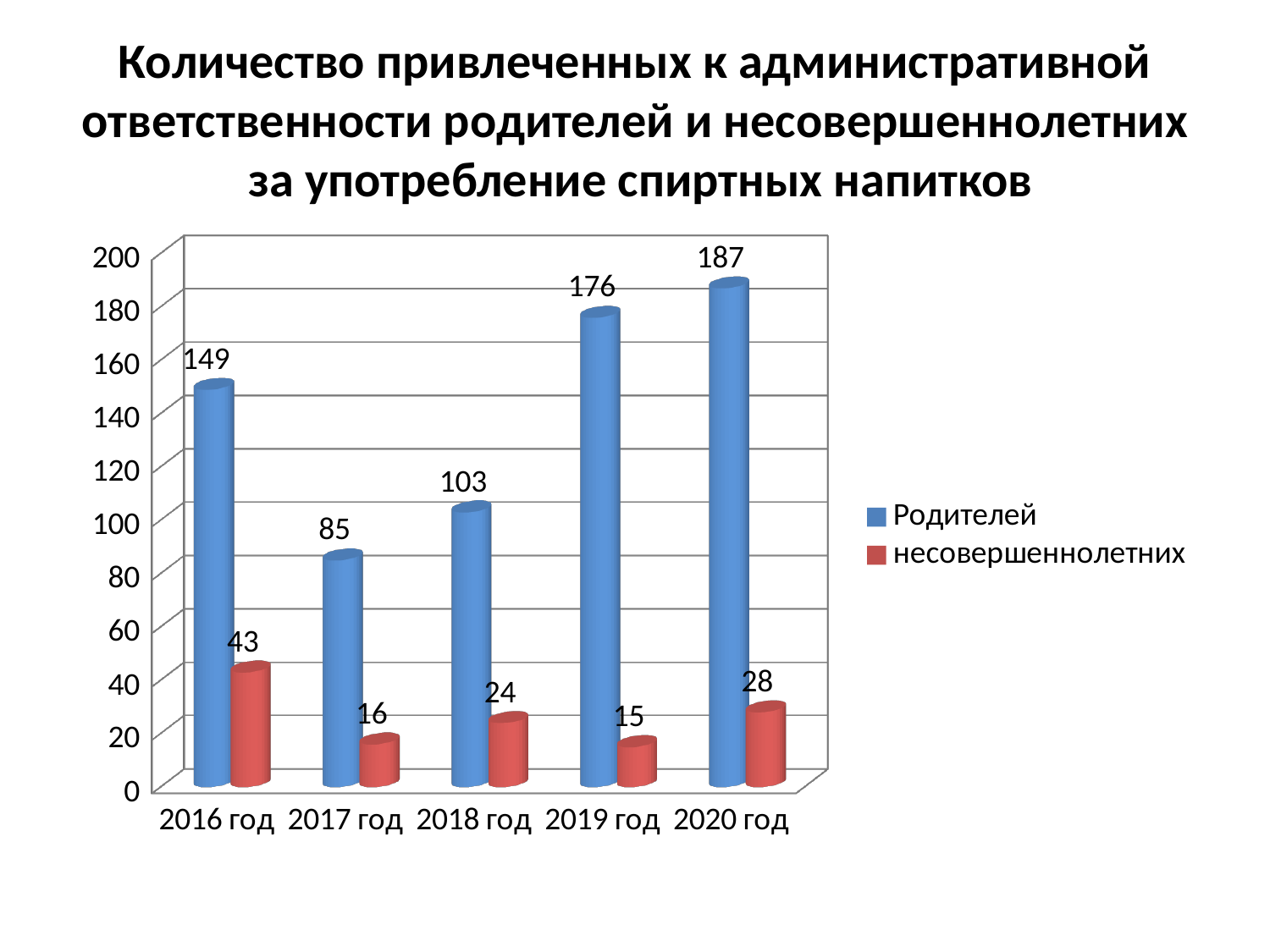
What is the value for несовершеннолетних in 2016 год? 43 Which is larger, the несовершеннолетних value for 2018 год or for 2020 год? 2020 год What is the value for Родителей in 2018 год? 103 What kind of chart is shown on the slide? bar chart What is the difference between the Родителей values for 2020 год and 2016 год? 38 Does the Родителей series rise or fall from 2017 год to 2020 год? rise What is the value for Родителей in 2020 год? 187 How many years are shown on the x axis? 5 Which colour represents the несовершеннолетних series? red How many series does the legend list? 2 Which year has the lowest value for несовершеннолетних? 2019 год Which year has the highest value for Родителей? 2020 год